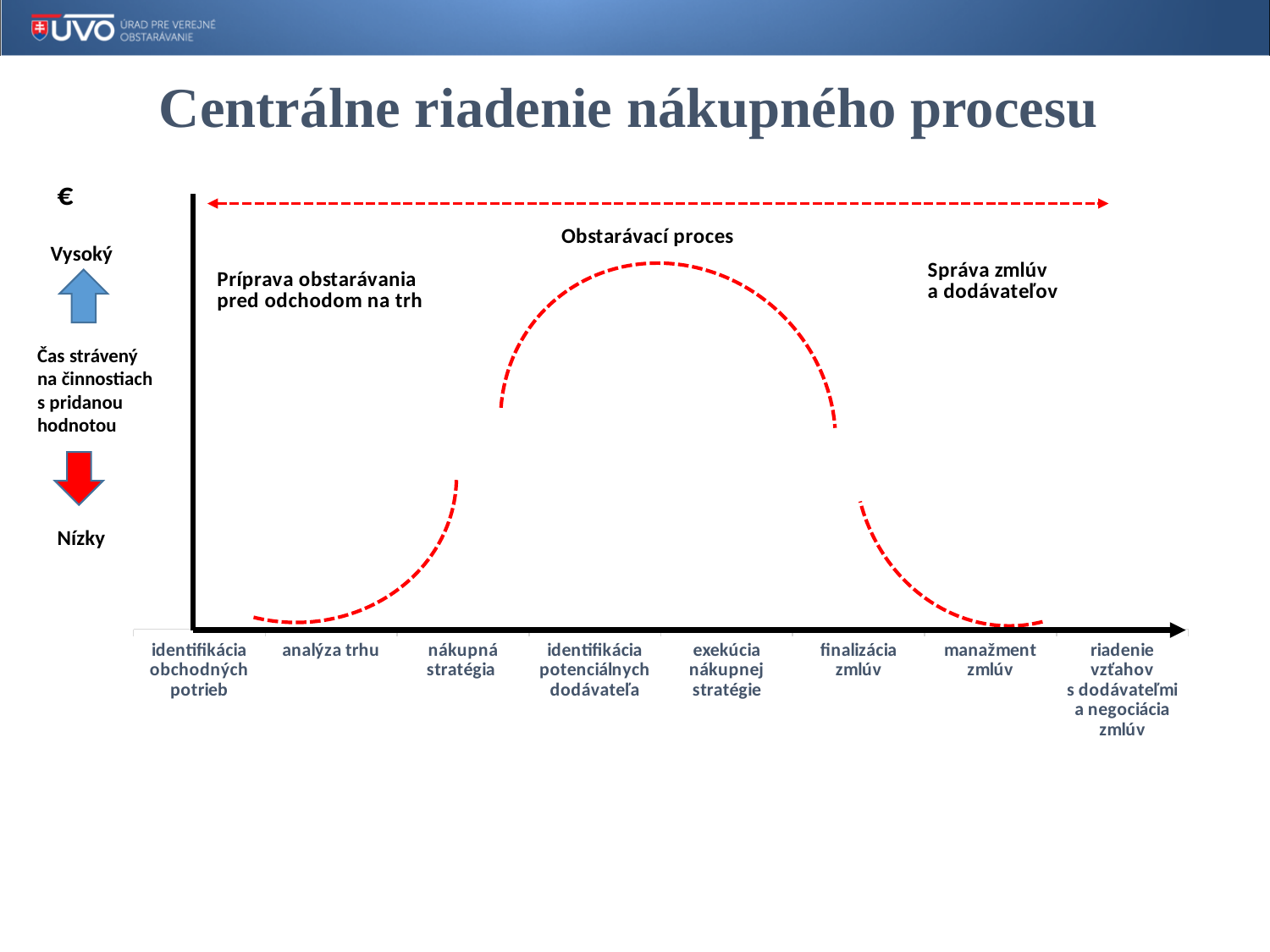
Does the curve rise or fall from finalizácia zmlúv to manažment zmlúv? fall Which is higher on the curve, analýza trhu or exekúcia nákupnej stratégie? exekúcia nákupnej stratégie What is the title of the chart on the slide? Centrálne riadenie nákupného procesu Which is higher on the curve, finalizácia zmlúv or manažment zmlúv? finalizácia zmlúv What kind of chart is shown on the slide? line chart How many process stages are labelled along the x axis? 8 Which phase label appears at the right side of the chart, above the falling part of the curve? Správa zmlúv a dodávateľov What is the last stage labelled on the x axis? riadenie vzťahov s dodávateľmi a negociácia zmlúv Does the curve rise or fall from identifikácia obchodných potrieb to nákupná stratégia? rise Which phase label is placed above the peak of the curve? Obstarávací proces Which is higher on the curve, identifikácia obchodných potrieb or nákupná stratégia? nákupná stratégia What are the two labels at the top and bottom of the vertical axis? Vysoký and Nízky